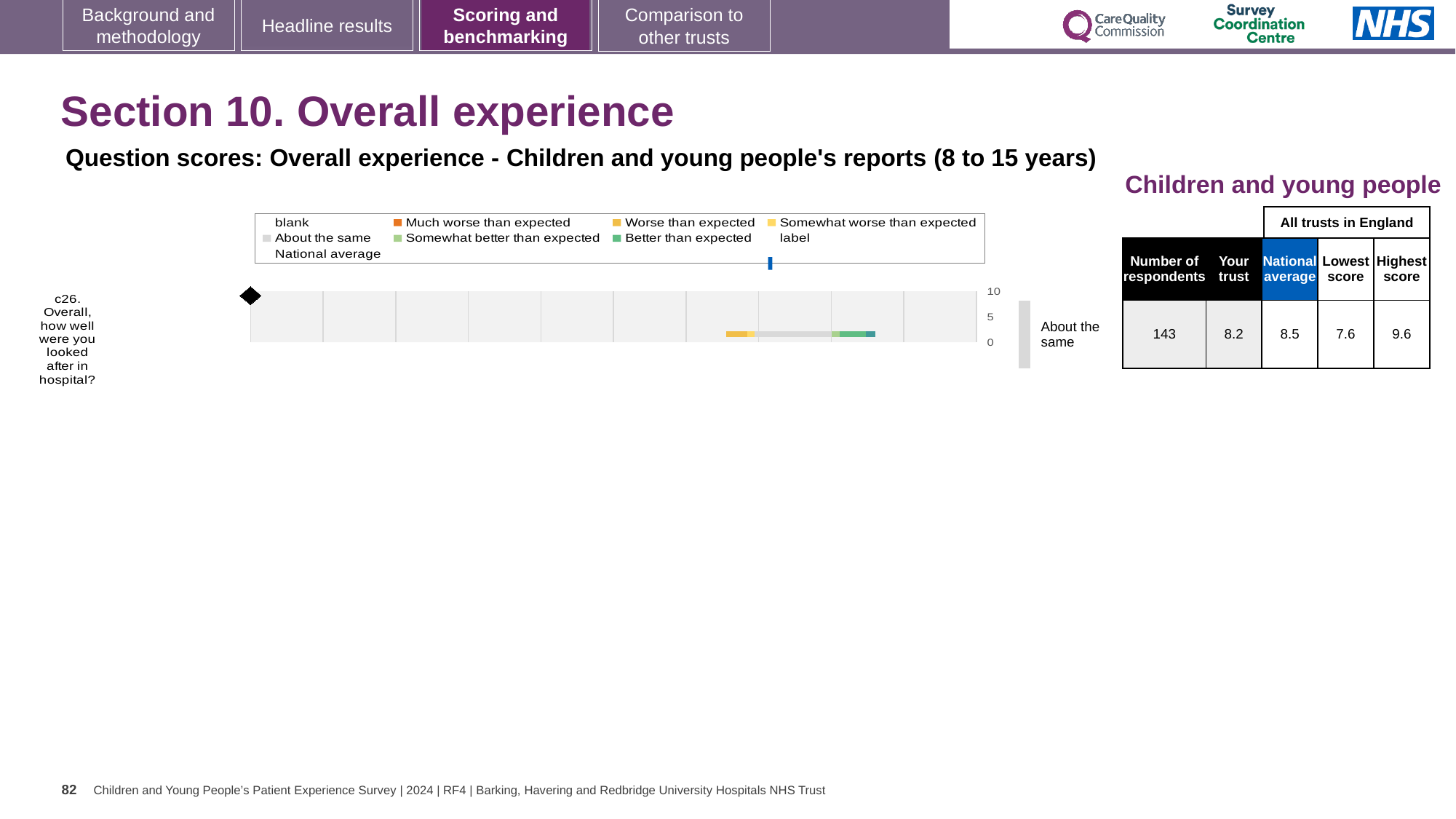
According to the table, what is the highest score among all trusts in England for question c26? 9.6 What is the question label shown on the left of the chart? c26. Overall, how well were you looked after in hospital? How many survey questions are plotted in the chart? 1 According to the table, what is the lowest score among all trusts in England for question c26? 7.6 According to the table next to the chart, what is the trust's score for question c26? 8.2 What is the difference between the highest score and the lowest score for question c26 in the table? 2.0 What kind of chart is shown on the slide for question c26? bar chart What is the highest value shown on the chart's numeric axis? 10 Which is larger for question c26: the trust's score or the national average? national average According to the table next to the chart, what is the national average score for question c26? 8.5 How many respondents answered question c26, according to the table? 143 What benchmark category is shown to the right of the chart for question c26? About the same